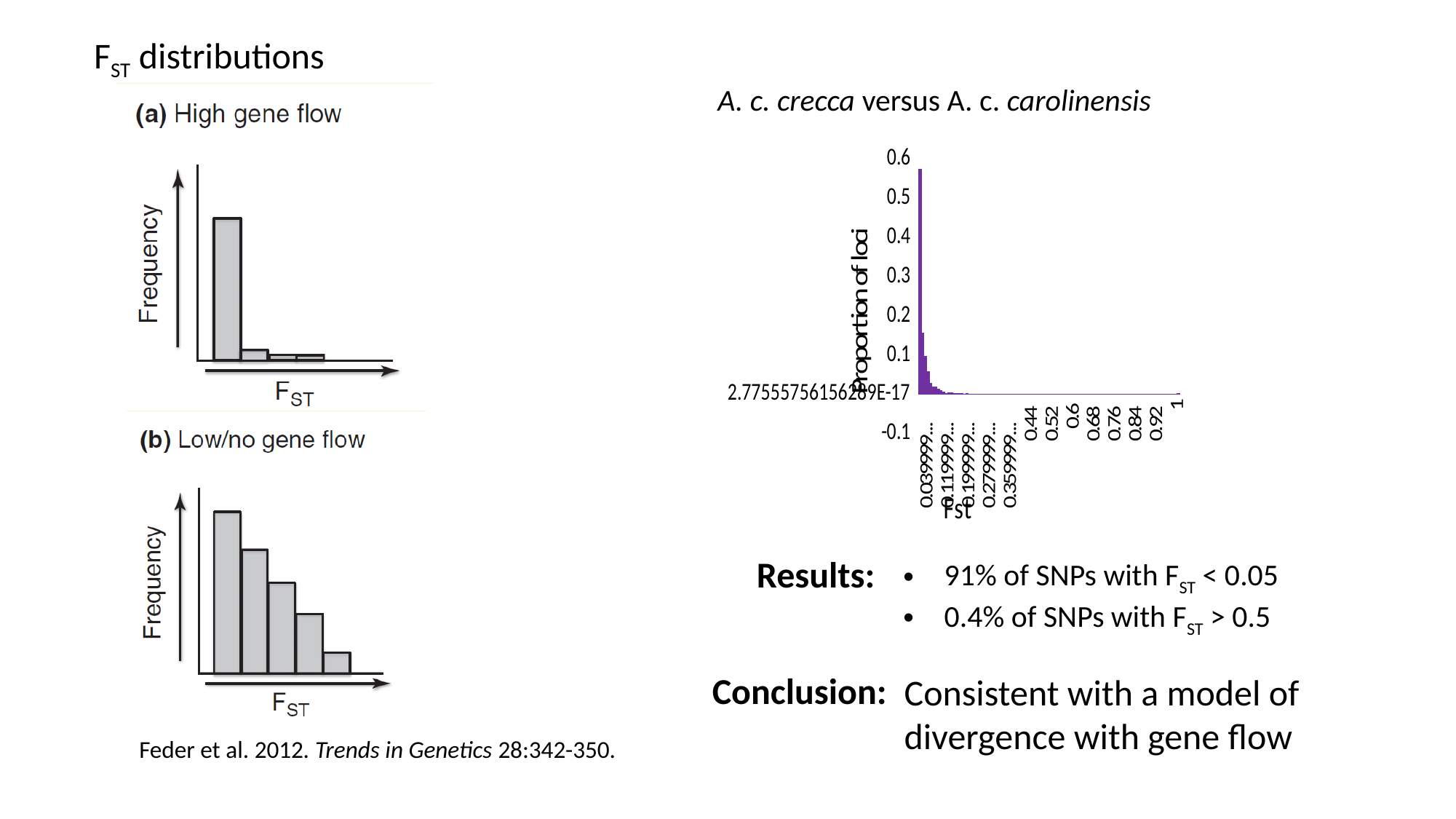
What colour are the bars in the 'A. c. crecca versus A. c. carolinensis' chart? purple What kind of chart is the 'A. c. crecca versus A. c. carolinensis' chart? bar chart What kind of chart is the '(b) Low/no gene flow' chart? bar chart How many bars are shown in the '(a) High gene flow' chart? 4 In the 'A. c. crecca versus A. c. carolinensis' chart, do the bar values rise or fall as Fst increases along the x axis? fall In the 'A. c. crecca versus A. c. carolinensis' chart, is the value of the second bar greater or less than 0.3? less In the '(b) Low/no gene flow' chart, do the bars rise or fall from left to right along the FST axis? fall In the '(a) High gene flow' chart, which bar is the highest? the first (leftmost) bar What is the y-axis label of the 'A. c. crecca versus A. c. carolinensis' chart? Proportion of loci In the 'A. c. crecca versus A. c. carolinensis' chart, which is larger: the first bar or the second bar? the first bar In the 'A. c. crecca versus A. c. carolinensis' chart, is the value of the tallest bar greater or less than 0.5? greater How many bars are shown in the '(b) Low/no gene flow' chart? 5